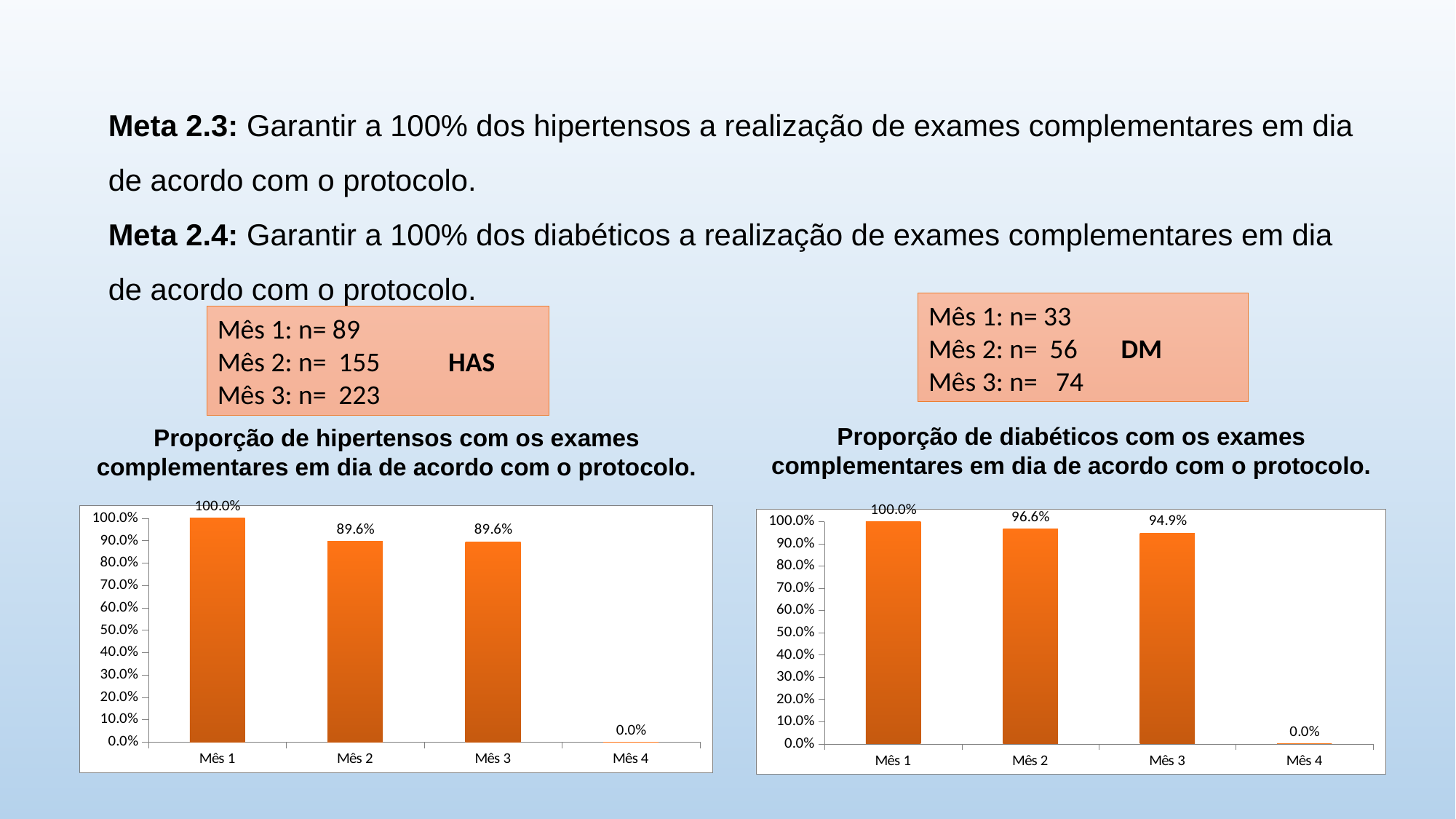
What is the title of the left chart? Proporção de hipertensos com os exames complementares em dia de acordo com o protocolo. What type of chart is the right chart (Proporção de diabéticos)? Bar chart In the right chart (Proporção de diabéticos), what is the value for Mês 2? 96.6% In the right chart (Proporção de diabéticos), do the values rise or fall from Mês 1 to Mês 3? Fall In the right chart (Proporção de diabéticos com os exames complementares em dia de acordo com o protocolo), what is the value for Mês 3? 94.9% In the right chart (Proporção de diabéticos), what is the difference between the values for Mês 1 and Mês 3? 5.1% Which is larger: the Mês 2 value in the left chart (hipertensos) or the Mês 2 value in the right chart (diabéticos)? The right chart (diabéticos), 96.6% In the left chart (Proporção de hipertensos), what is the difference between the values for Mês 1 and Mês 2? 10.4% In the left chart (Proporção de hipertensos), which month has the highest value? Mês 1 In the left chart (Proporção de hipertensos com os exames complementares em dia de acordo com o protocolo), what is the value for Mês 2? 89.6% In the right chart (Proporção de diabéticos), which month has the lowest value? Mês 4 In the left chart (Proporção de hipertensos), how many month categories are shown on the x axis? 4